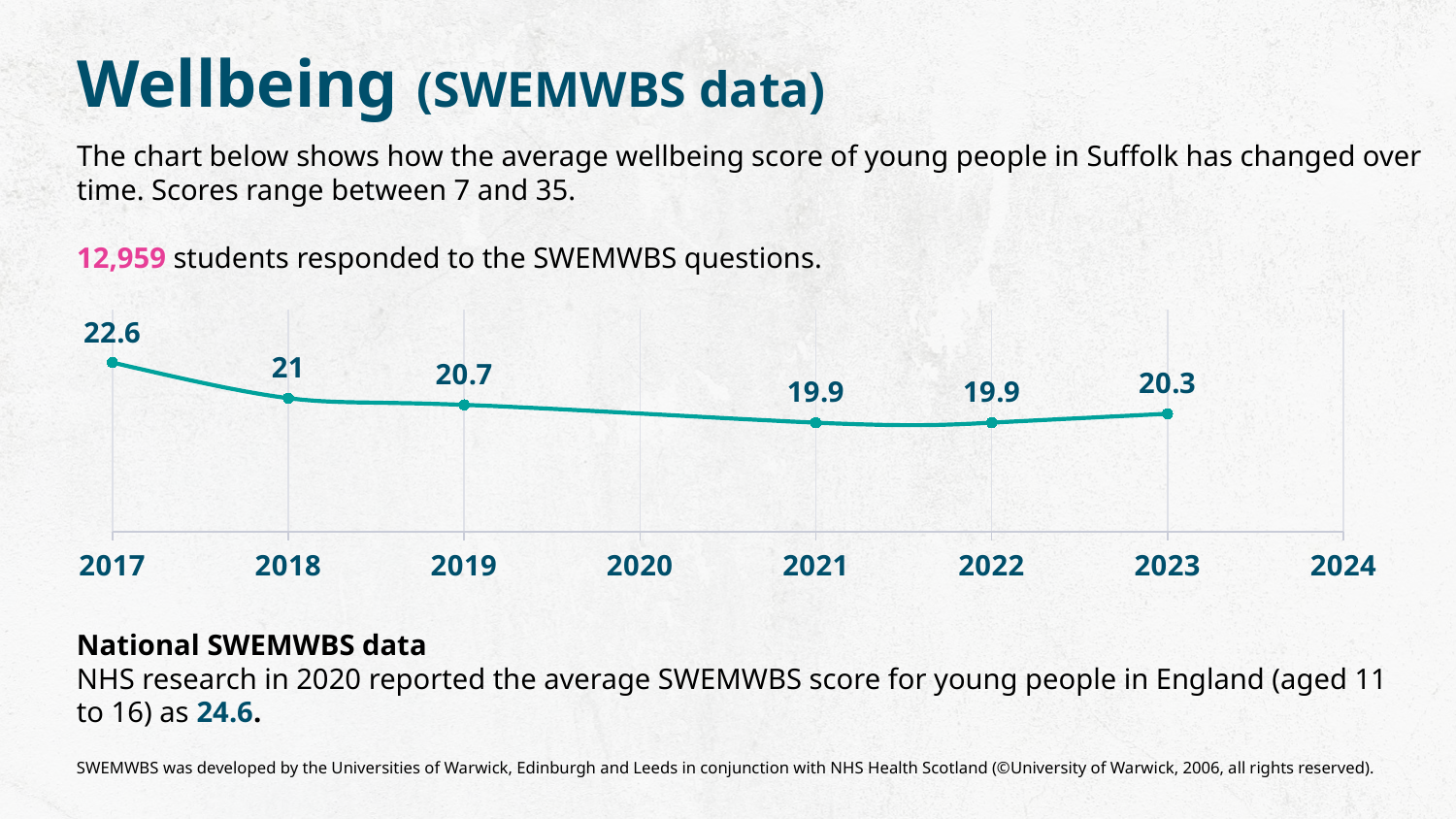
What was the average wellbeing score in 2023? 20.3 What was the average wellbeing score in 2017? 22.6 Which year has the highest average wellbeing score? 2017 How many data points are plotted on the chart? 6 What was the average wellbeing score in 2019? 20.7 What is the difference between the 2017 score and the 2023 score? 2.3 How many students responded to the SWEMWBS questions? 12,959 Does the average wellbeing score rise or fall from 2017 to 2021? Fall Which is larger, the score for 2022 or the score for 2023? 2023 What is the difference between the 2018 score and the 2019 score? 0.3 What is the lowest average wellbeing score plotted on the chart? 19.9 What kind of chart is shown on the slide? Line chart